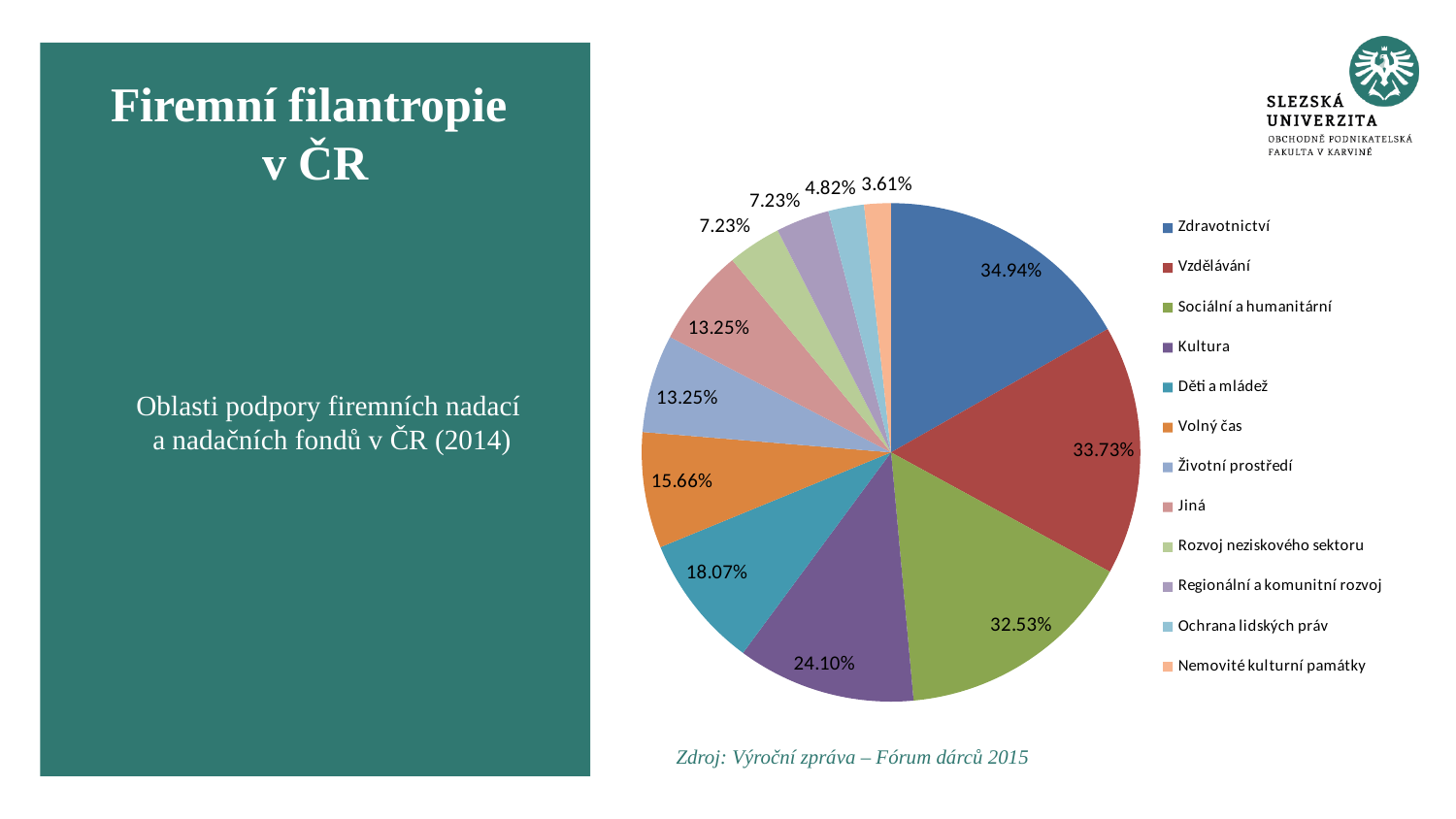
Which is larger, the value for Sociální a humanitární or the value for Kultura? Sociální a humanitární What is the value shown for Nemovité kulturní památky? 3.61% What is the value shown for Děti a mládež? 18.07% What is the value shown for Kultura? 24.10% Which category has the smallest slice of the pie? Nemovité kulturní památky What is the difference between the values for Kultura and Volný čas? 8.44% What source is cited below the chart? Výroční zpráva – Fórum dárců 2015 What is the difference between the values for Zdravotnictví and Vzdělávání? 1.21% How many categories does the legend list? 12 Which category has the largest slice of the pie? Zdravotnictví What is the value shown for Zdravotnictví? 34.94% What kind of chart is shown on the slide? pie chart